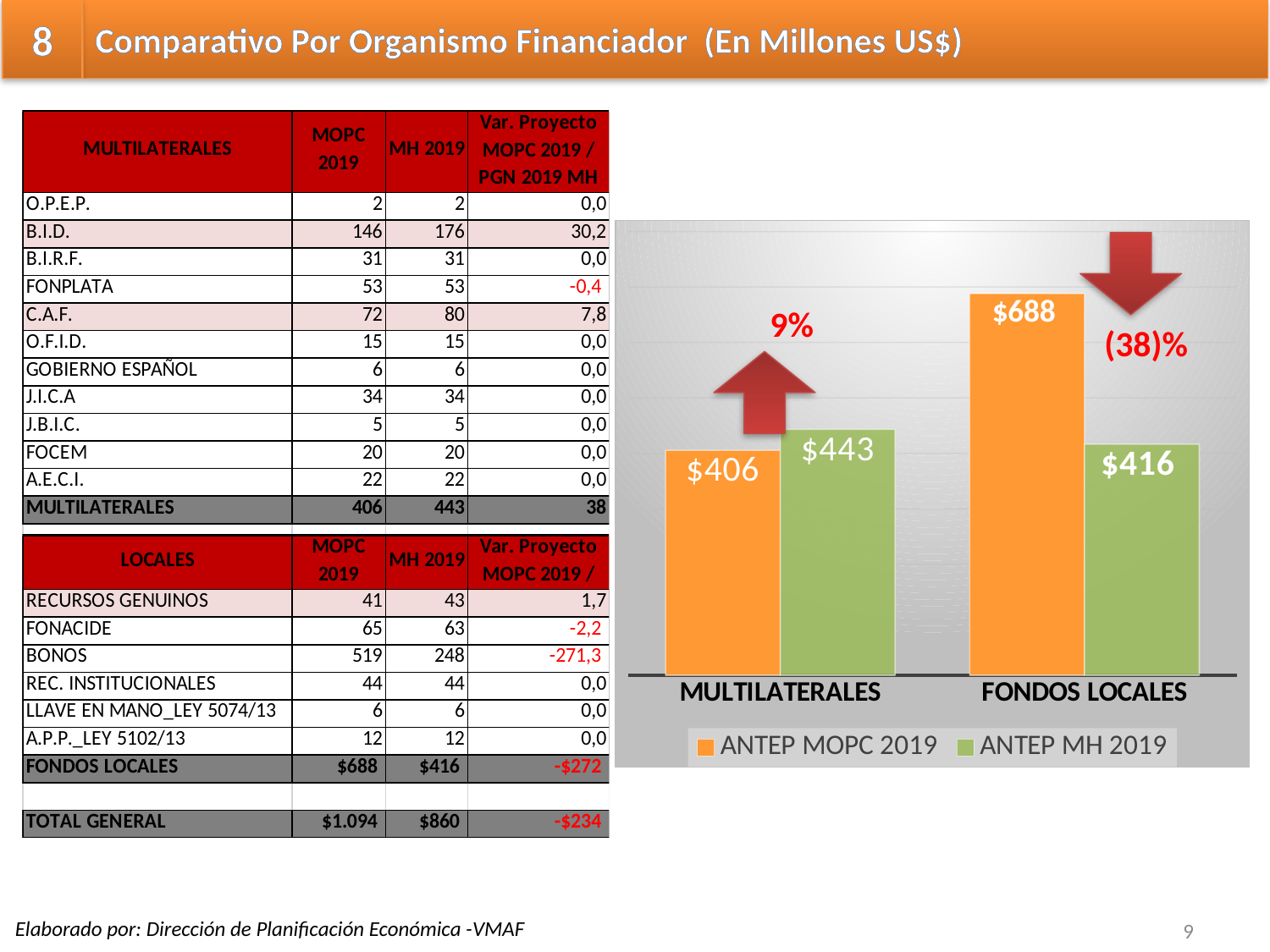
What is the value of ANTEP MH 2019 for MULTILATERALES? $443 What is the value of ANTEP MH 2019 for FONDOS LOCALES? $416 What is the value of ANTEP MOPC 2019 for MULTILATERALES? $406 What kind of chart is shown on the slide? bar chart Which category has the lowest ANTEP MH 2019 value? FONDOS LOCALES What is the value of ANTEP MOPC 2019 for FONDOS LOCALES? $688 How many categories are shown on the x axis of the chart? 2 What percentage change is annotated above the FONDOS LOCALES bars? (38)% How many series does the chart legend list? 2 For MULTILATERALES, which is larger: ANTEP MOPC 2019 or ANTEP MH 2019? ANTEP MH 2019 Which category has the highest ANTEP MOPC 2019 value? FONDOS LOCALES What is the difference between ANTEP MOPC 2019 and ANTEP MH 2019 for FONDOS LOCALES? $272